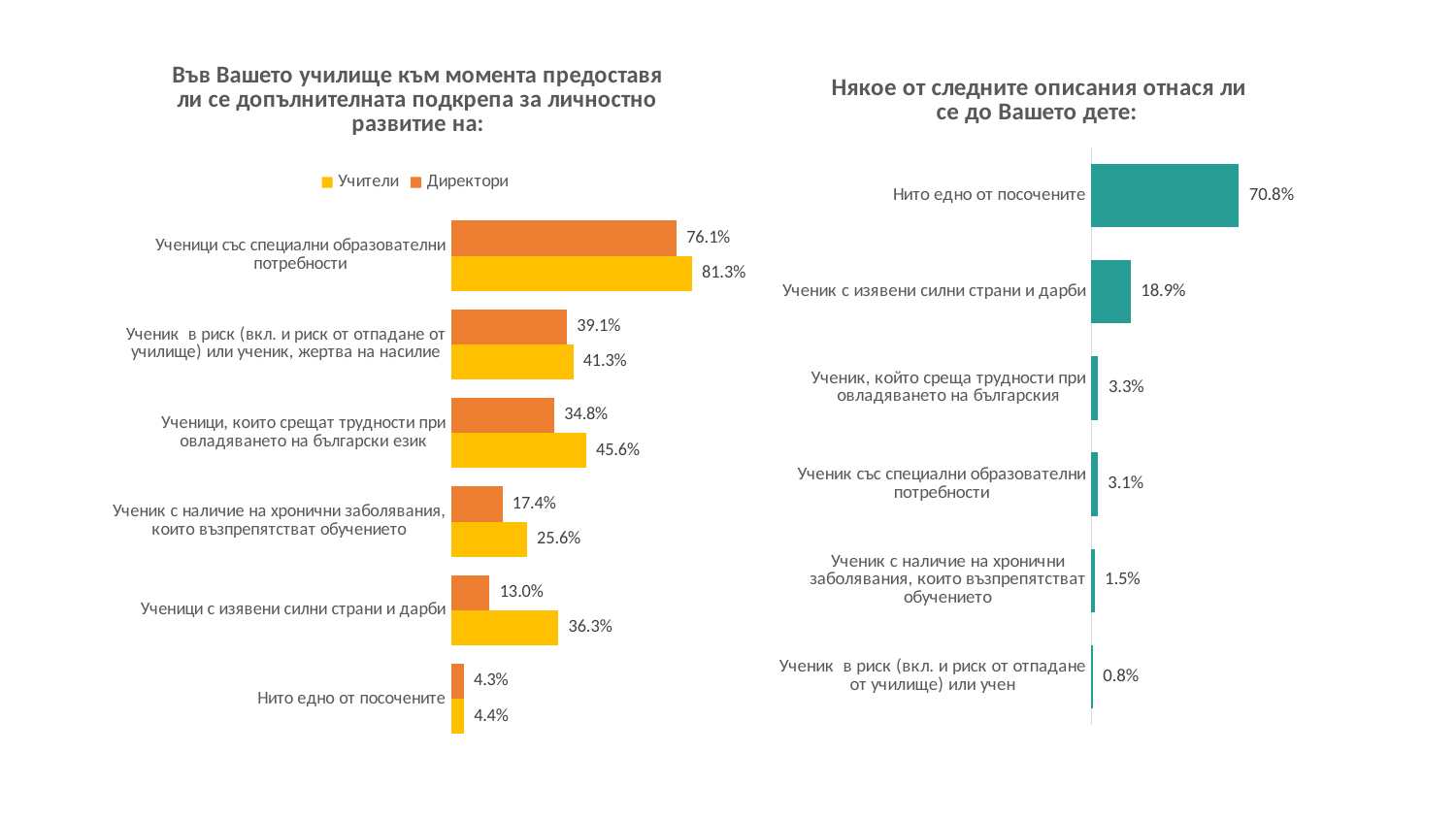
In the left chart, what is the difference between the Учители and Директори values for 'Ученици, които срещат трудности при овладяването на български език'? 10.8% In the left chart, what is the value for Директори for 'Ученици с изявени силни страни и дарби'? 13.0% In the left chart, what colour are the bars for Директори? Orange What type of chart is the right chart? Bar chart In the left chart, what is the value for Учители for 'Ученици със специални образователни потребности'? 81.3% In the right chart, how many categories are shown? 6 In the right chart, which category has the lowest value? Ученик в риск (вкл. и риск от отпадане от училище) или учен In the left chart, which series has the larger value for 'Ученик с наличие на хронични заболявания, които възпрепятстват обучението'? Учители In the left chart, how many series does the legend list? 2 In the left chart, which category has the lowest Директори value? Нито едно от посочените In the right chart, what is the value for 'Нито едно от посочените'? 70.8% In the right chart, what is the difference between 'Нито едно от посочените' and 'Ученик с изявени силни страни и дарби'? 51.9%